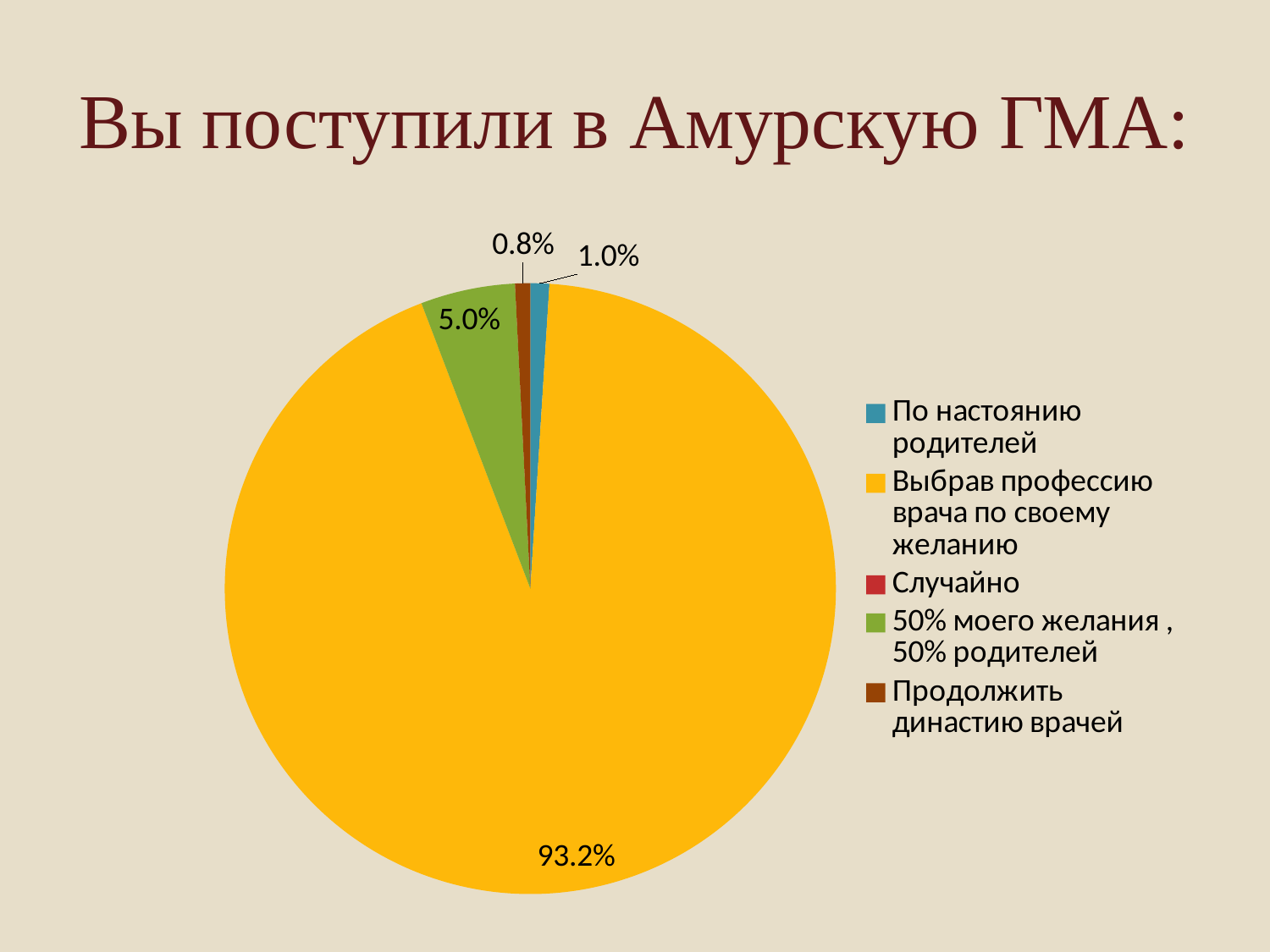
What percentage is shown for "Выбрав профессию врача по своему желанию"? 93.2% What kind of chart is shown on the slide? Pie chart How many entries does the legend of the pie chart list? 5 Which category has the largest slice of the pie? Выбрав профессию врача по своему желанию What colour is the largest slice of the pie chart? Yellow What percentage is shown for "По настоянию родителей"? 1.0% Which is larger: the share for "По настоянию родителей" or for "Продолжить династию врачей"? По настоянию родителей What is the difference in percentage points between "Выбрав профессию врача по своему желанию" and "50% моего желания, 50% родителей"? 88.2 What percentage is shown for "50% моего желания, 50% родителей"? 5.0% What is the title of the slide? Вы поступили в Амурскую ГМА: What is the difference in percentage points between "50% моего желания, 50% родителей" and "По настоянию родителей"? 4.0 What percentage is shown for "Продолжить династию врачей"? 0.8%